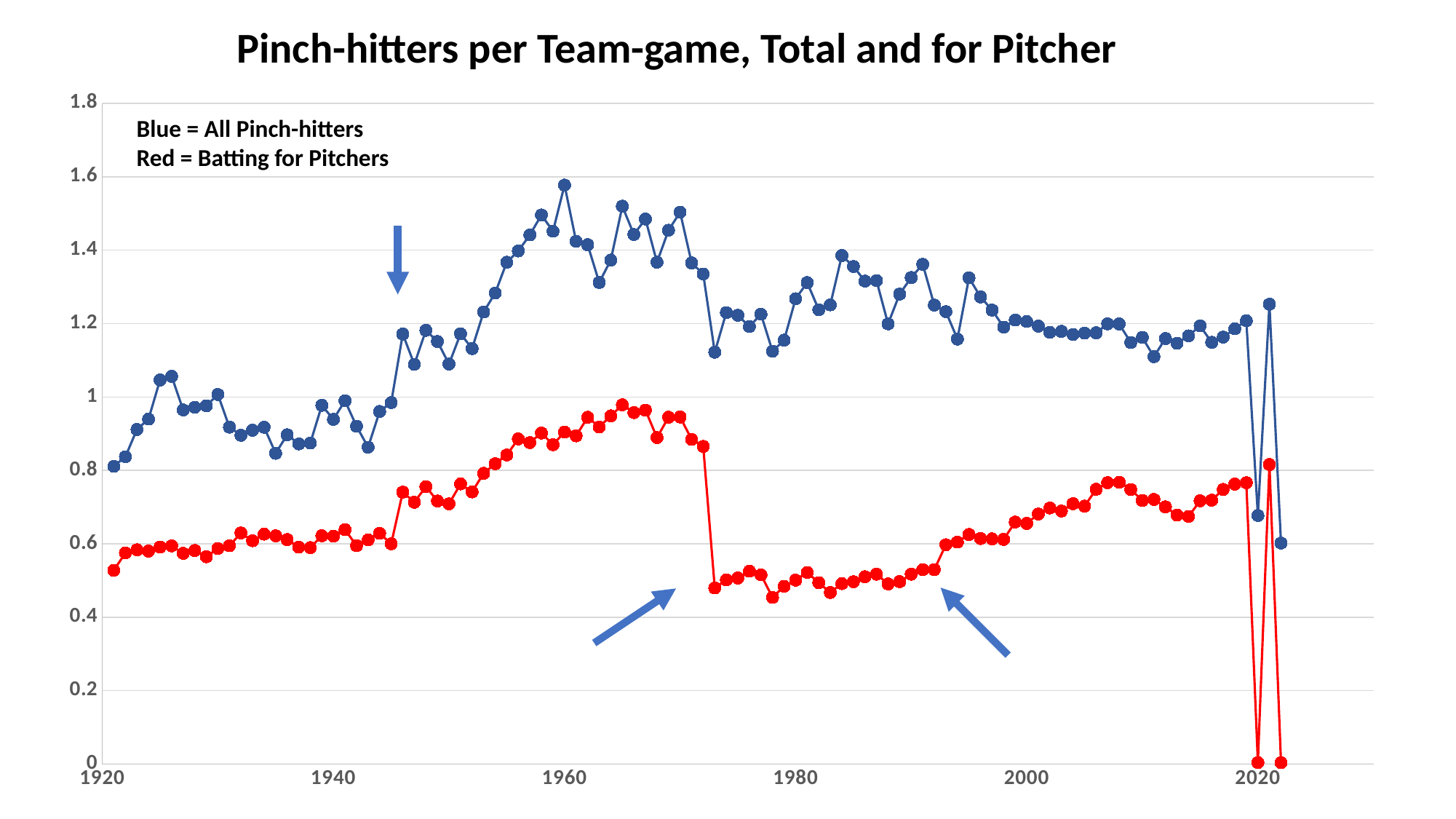
What kind of chart is shown on the slide? Line chart In which year does the blue (All Pinch-hitters) series reach its highest value? 1960 Which series has the higher values across the whole chart, blue or red? Blue Which is larger: the red series value in 1965 or the red series value in 1975? 1965 Does the red series generally rise or fall between 1973 and 2008? Rise What value does the red (Batting for Pitchers) series show for 2020? 0 What is the title of the chart? Pinch-hitters per Team-game, Total and for Pitcher According to the legend text, what does the red series represent? Batting for Pitchers Is the value of the blue series in 1960 greater or less than 1.4? greater Is the value of the red series in 1973 greater or less than 0.6? less How many data series does the chart show? 2 Is the value of the blue series in 1921 greater or less than 1? less